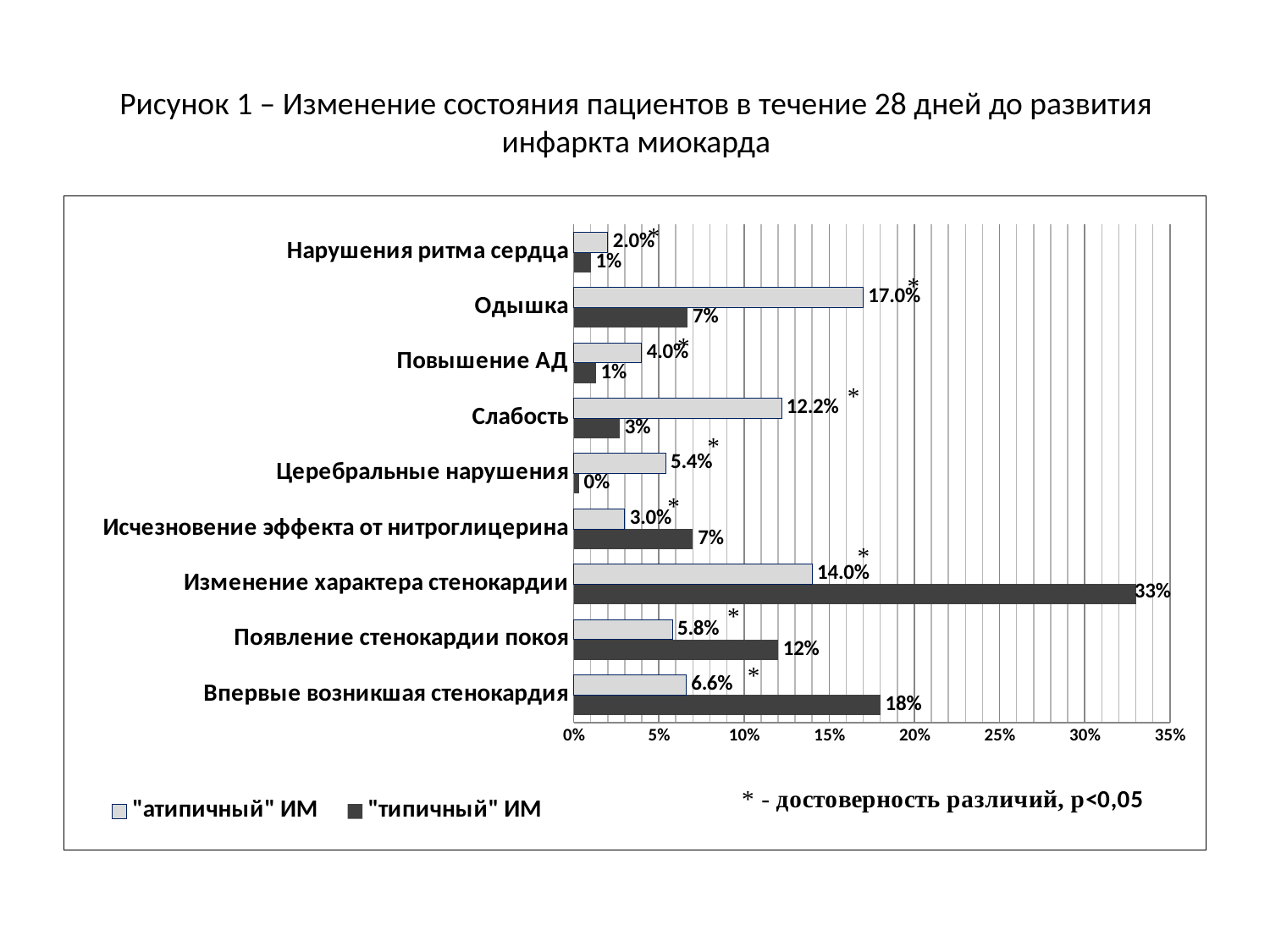
What is the value for "типичный" ИМ in the category Впервые возникшая стенокардия? 18% For the category Слабость, which series has the larger value: "атипичный" ИМ or "типичный" ИМ? "атипичный" ИМ What is the value for "атипичный" ИМ in the category Церебральные нарушения? 5.4% What does the asterisk (*) on the chart denote, according to the note on the slide? достоверность различий, p<0,05 What is the value for "атипичный" ИМ in the category Одышка? 17.0% What is the difference between the "типичный" ИМ and "атипичный" ИМ values for Появление стенокардии покоя? 6.2% Which category has the lowest value for "типичный" ИМ? Церебральные нарушения How many categories are shown on the chart? 9 What type of chart is shown on the slide? bar chart Which category has the highest value for "атипичный" ИМ? Одышка What is the value for "типичный" ИМ in the category Изменение характера стенокардии? 33% How many series does the legend list? 2